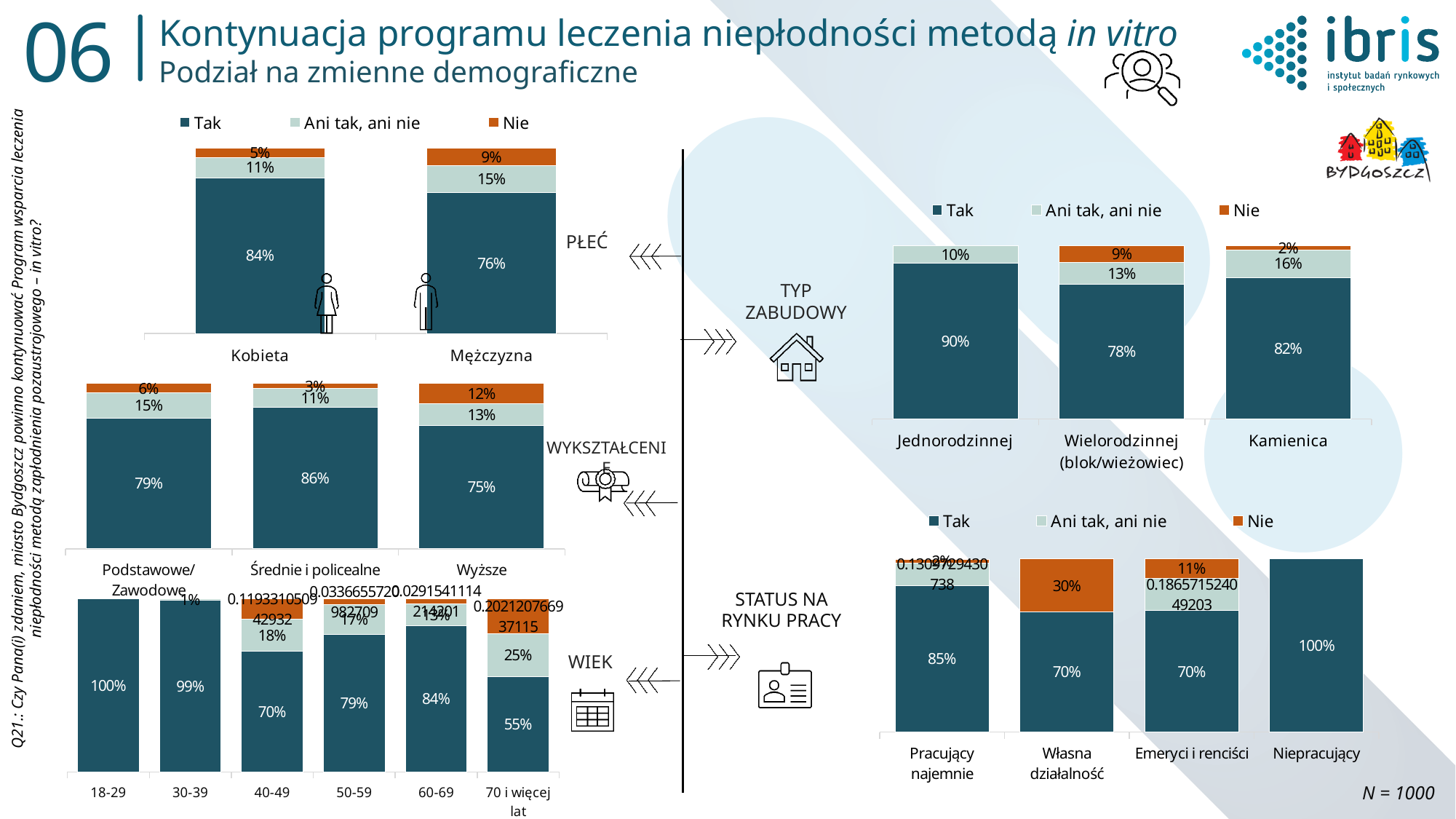
How many series does the legend of the STATUS NA RYNKU PRACY chart list? 3 In the PŁEĆ chart, what is the Nie share for Mężczyzna? 9% How many age groups are shown in the WIEK chart? 6 In the WYKSZTAŁCENIE chart, what is the Nie share for Wyższe? 12% In the STATUS NA RYNKU PRACY chart, what is the Nie share for Własna działalność? 30% In the WIEK chart, which age group has the lowest Tak share? 70 i więcej lat In the PŁEĆ chart, what percentage of Kobieta answered Tak? 84% In the WIEK chart, what is the Ani tak, ani nie share for the 70 i więcej lat group? 25% In the WYKSZTAŁCENIE chart, which education group has the highest Tak share? Średnie i policealne In the TYP ZABUDOWY chart, what is the Tak share for Jednorodzinnej? 90% In the PŁEĆ chart, what is the difference between the Tak values for Kobieta and Mężczyzna? 8 percentage points In the TYP ZABUDOWY chart, which is larger: the Tak share for Wielorodzinnej (blok/wieżowiec) or for Kamienica? Kamienica